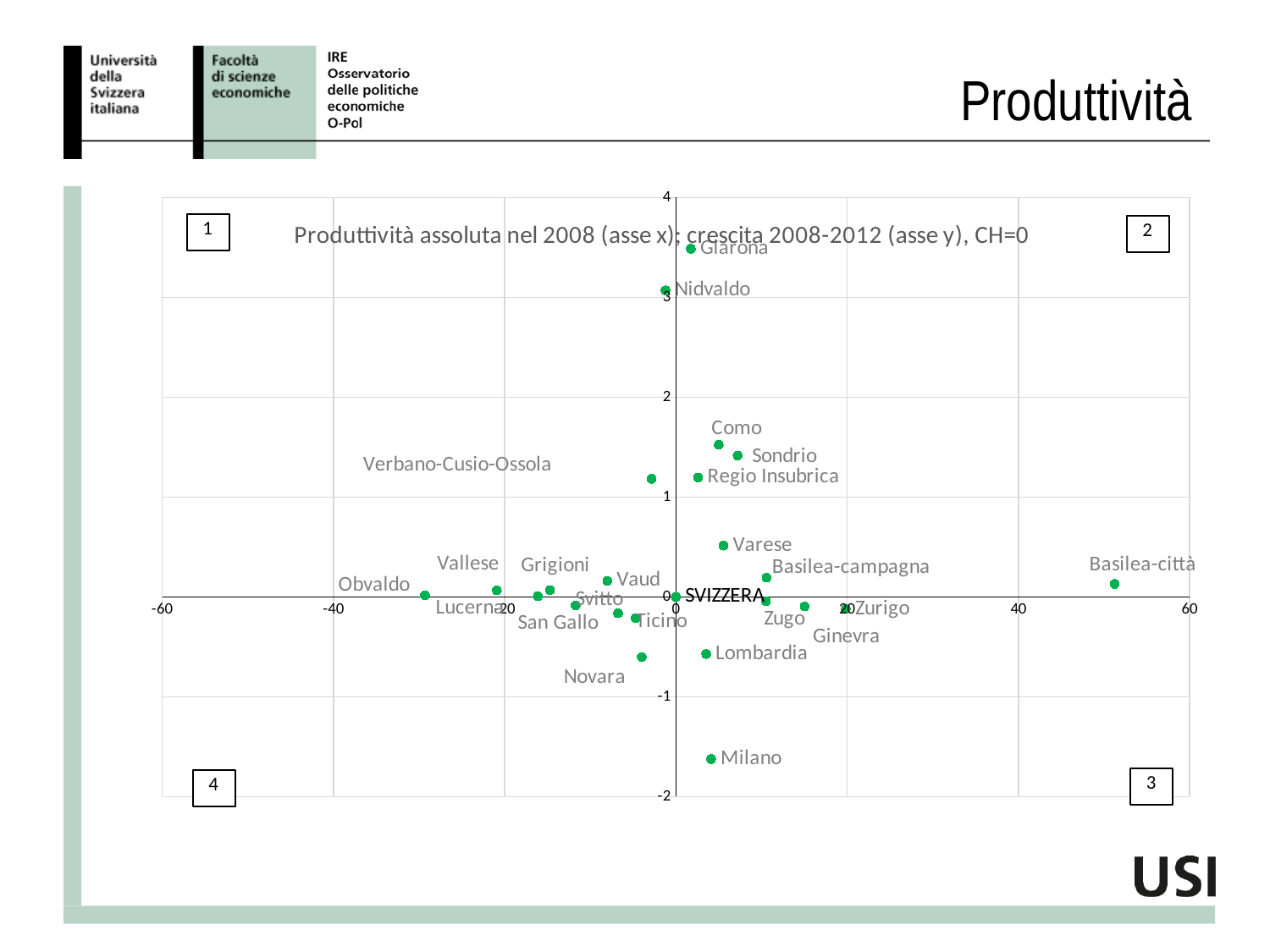
Which point has the highest value on the y axis? Glarona Is the y-axis value for Como greater or less than 1? greater Is the x-axis value for Obvaldo greater or less than -20? less Which has the larger y-axis value, Glarona or Milano? Glarona What kind of chart is shown on the slide? scatter chart Which point has the highest value on the x axis? Basilea-città Is the y-axis value for Milano greater or less than -1? less Which point has the lowest value on the y axis? Milano What is the title of the chart? Produttività assoluta nel 2008 (asse x); crescita 2008-2012 (asse y), CH=0 Which point has the lowest value on the x axis? Obvaldo